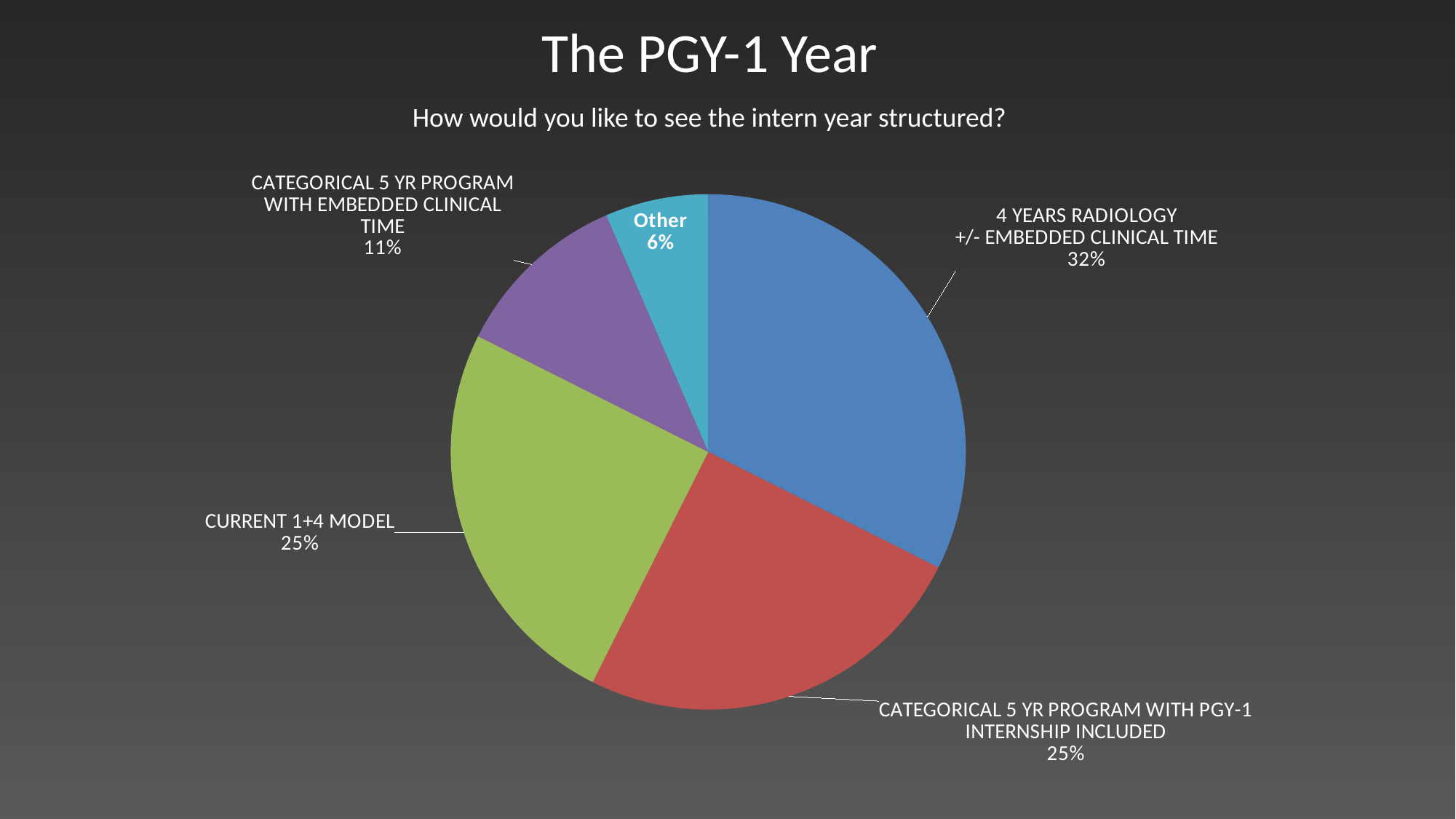
Which is larger: 'CATEGORICAL 5 YR PROGRAM WITH EMBEDDED CLINICAL TIME' or 'Other'? CATEGORICAL 5 YR PROGRAM WITH EMBEDDED CLINICAL TIME What is the title of the chart? How would you like to see the intern year structured? What share of the pie does '4 YEARS RADIOLOGY +/- EMBEDDED CLINICAL TIME' represent? 32% How many slices does the pie chart have? 5 What is the difference in percentage points between '4 YEARS RADIOLOGY +/- EMBEDDED CLINICAL TIME' and 'CURRENT 1+4 MODEL'? 7% What share of the pie does 'Other' represent? 6% What type of chart is shown on the slide? pie chart What share of the pie does 'CURRENT 1+4 MODEL' represent? 25% Which slice of the pie is the largest? 4 YEARS RADIOLOGY +/- EMBEDDED CLINICAL TIME Which slice of the pie is the smallest? Other